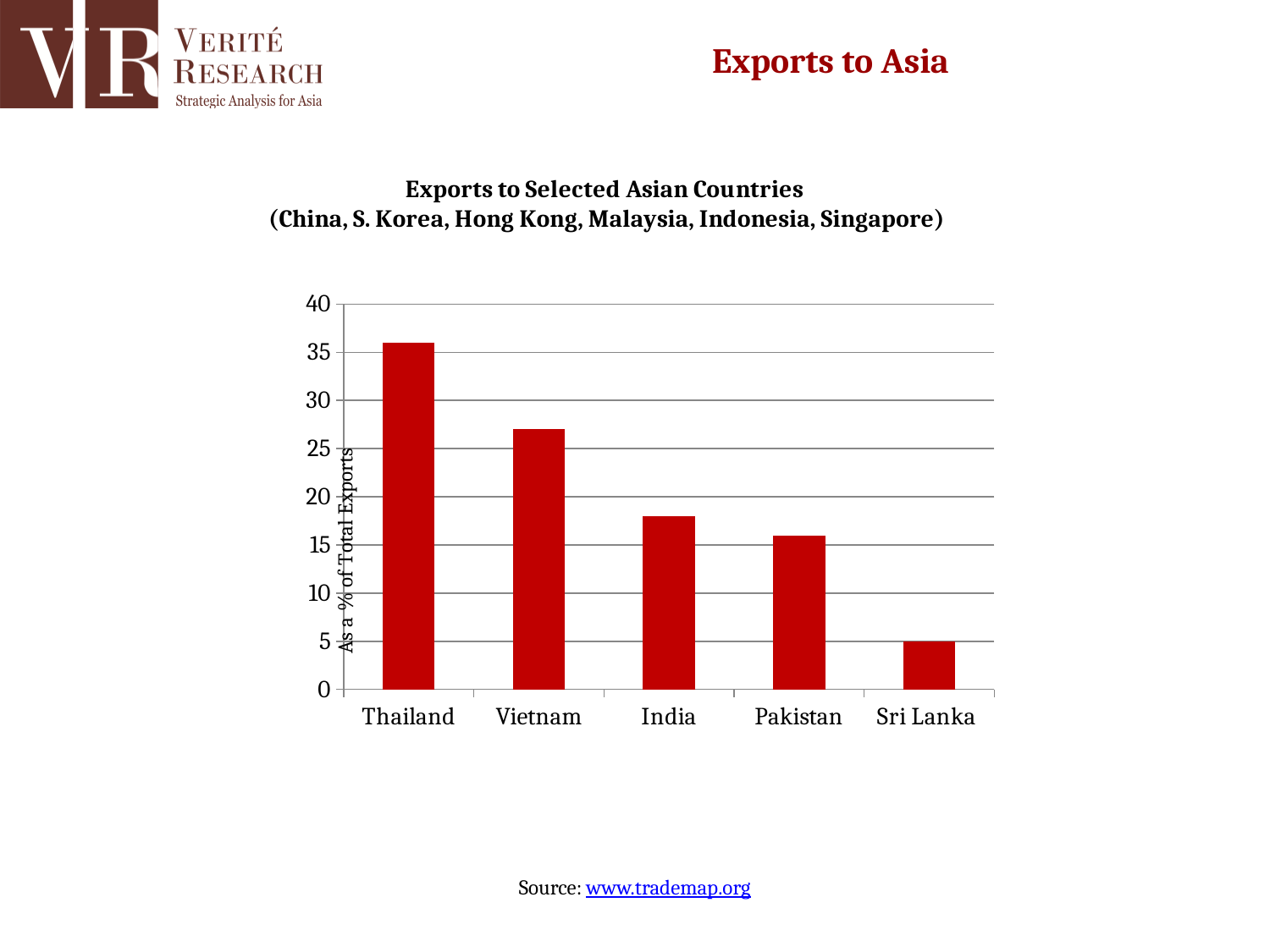
Is the value for Pakistan greater or less than 15? greater Which country has the highest share of exports to the selected Asian countries? Thailand Do the values rise or fall moving from Thailand to Sri Lanka along the x axis? Fall Which has a larger value, Thailand or Vietnam? Thailand How many countries are shown on the x axis of the chart? 5 Which country has the lowest share of exports to the selected Asian countries? Sri Lanka Is the value for Vietnam greater or less than 25? greater Is the value for Thailand greater or less than 35? greater Which has a larger value, Vietnam or Sri Lanka? Vietnam What kind of chart is shown on the slide? Bar chart What is the label on the vertical axis of the chart? As a % of Total Exports